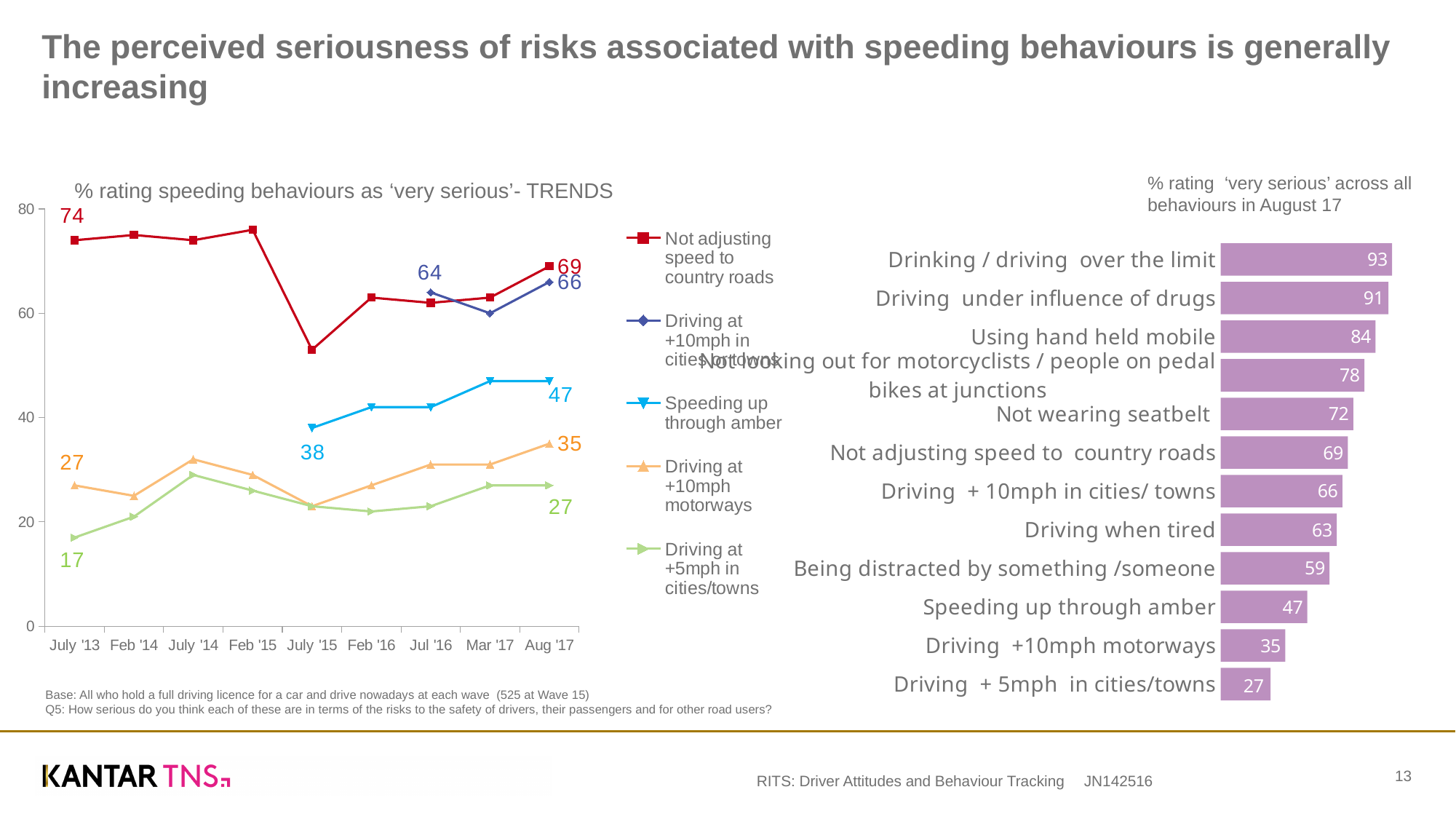
In the line chart on the left, what was the value for 'Not adjusting speed to country roads' in July '13? 74 What type of chart is shown on the right side of the slide? Bar chart In the line chart on the left, by how much did 'Driving at +5mph in cities/towns' change from July '13 to Aug '17? 10 In the line chart on the left, what was the value for 'Speeding up through amber' in Aug '17? 47 In the bar chart on the right, how many behaviours are listed? 12 In the bar chart on the right, which behaviour has the lowest percentage rating it 'very serious'? Driving + 5mph in cities/towns In the line chart on the left, how many series does the legend list? 5 In the line chart on the left, how many time points are shown on the x axis? 9 In the line chart on the left, is the value for 'Not adjusting speed to country roads' in July '15 greater or less than 60? less In the bar chart on the right, what percentage rated 'Drinking / driving over the limit' as very serious? 93 In the bar chart on the right, which is higher: 'Driving when tired' or 'Being distracted by something /someone'? Driving when tired In the bar chart on the right, what is the difference between 'Using hand held mobile' and 'Not wearing seatbelt'? 12